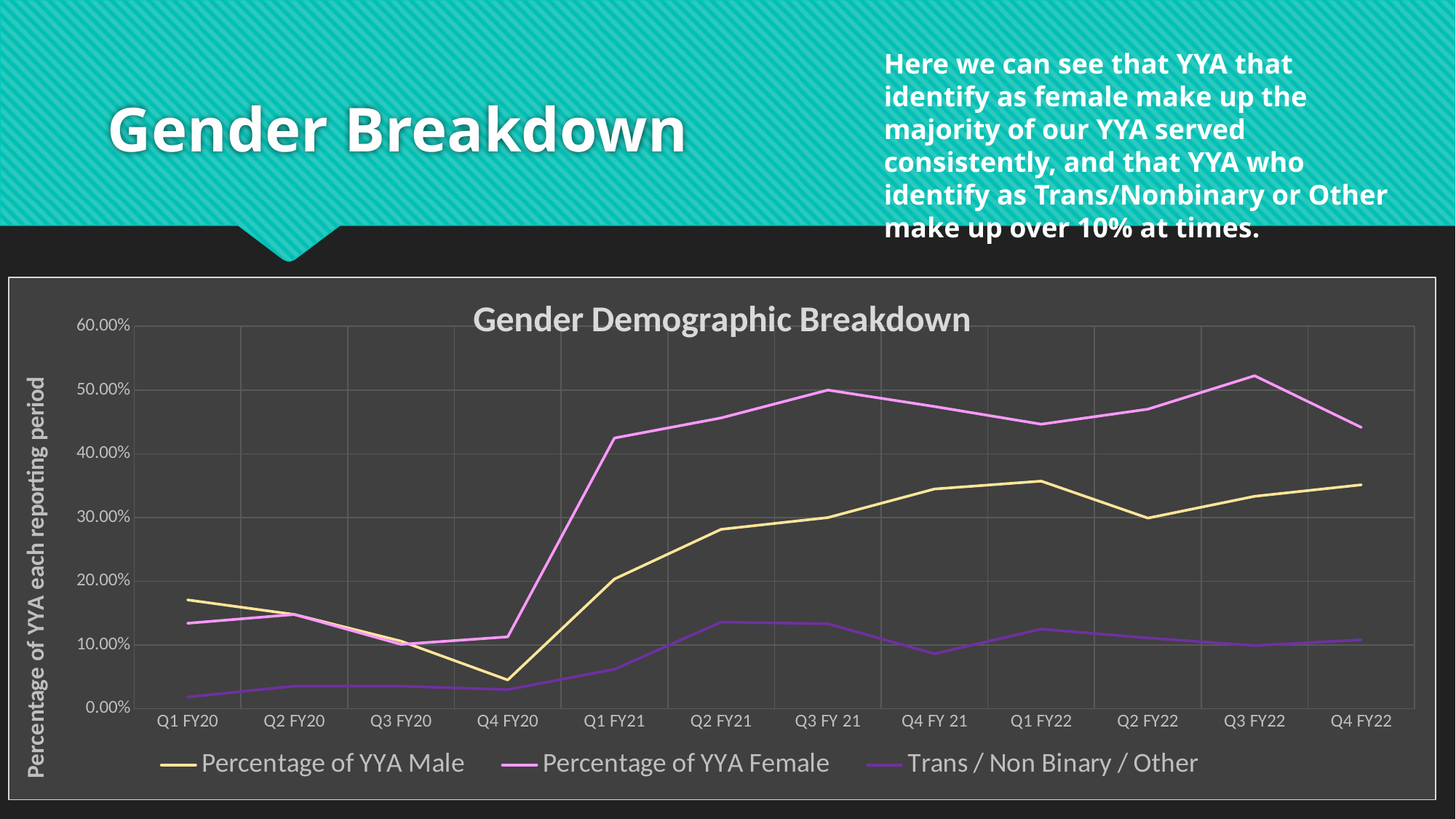
What type of chart is shown on the slide? Line chart In which reporting period is the Percentage of YYA Male at its lowest? Q4 FY20 In Q1 FY20, which is larger: Percentage of YYA Male or Percentage of YYA Female? Percentage of YYA Male Is the Percentage of YYA Male in Q4 FY20 greater or less than 10.00%? less What is the title of the chart on the slide? Gender Demographic Breakdown Is the Trans / Non Binary / Other value in Q2 FY21 greater or less than 10.00%? greater How many reporting periods are shown on the x axis of the chart? 12 In Q4 FY22, which is larger: Percentage of YYA Female or Percentage of YYA Male? Percentage of YYA Female Does the Percentage of YYA Female rise or fall from Q4 FY20 to Q3 FY 21? Rise Is the Percentage of YYA Female in Q3 FY 21 greater or less than 40.00%? greater How many series does the legend of the Gender Demographic Breakdown chart list? 3 In which reporting period does the Percentage of YYA Female reach its highest value? Q3 FY22